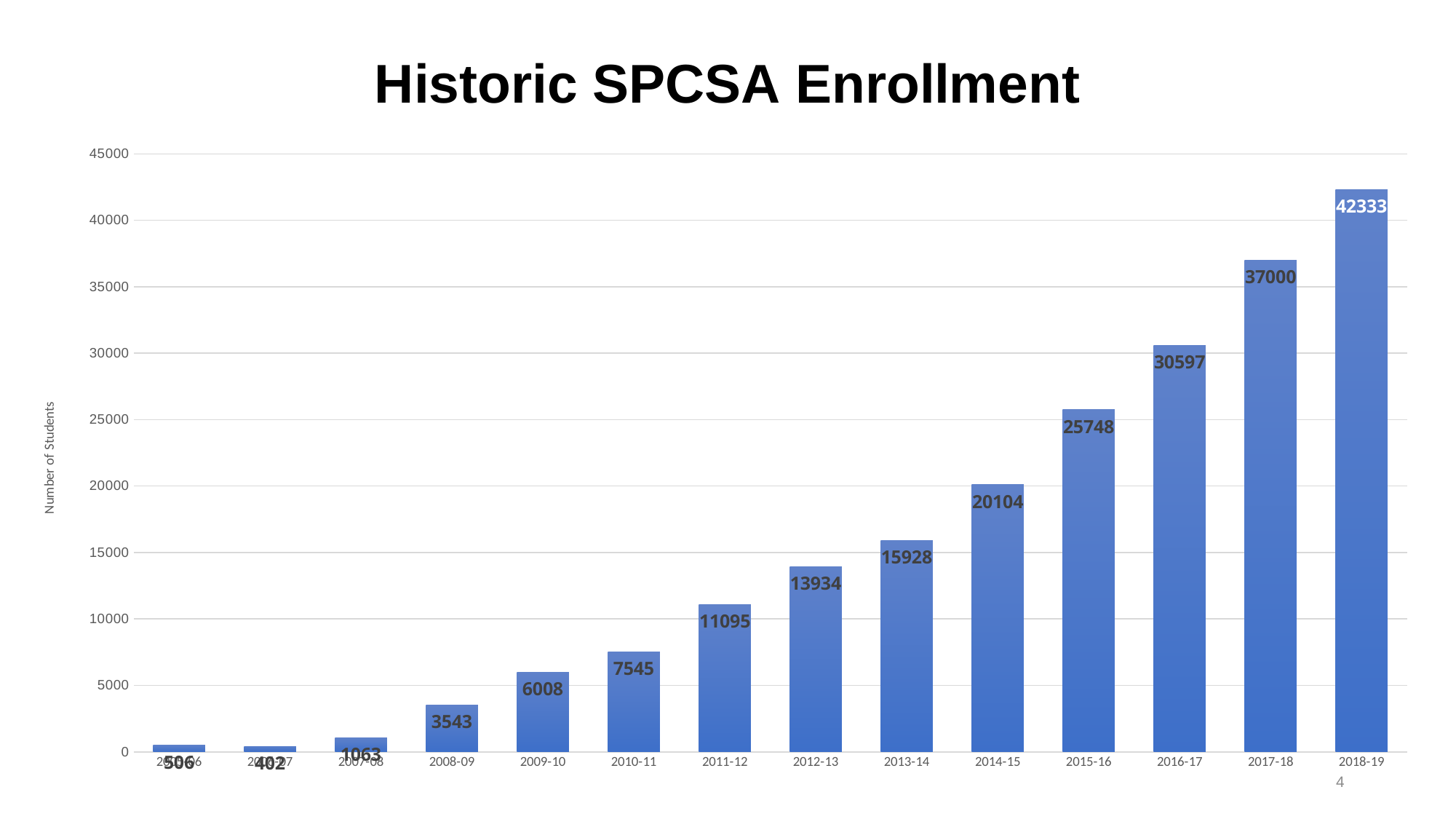
Which school year has the highest enrollment? 2018-19 What is the difference in enrollment between 2018-19 and 2017-18? 5333 What is the enrollment value for 2012-13? 13934 Which has higher enrollment, 2011-12 or 2013-14? 2013-14 What kind of chart is shown on the slide? Bar chart What is the enrollment value for 2009-10? 6008 How many school years are shown in the chart? 14 Does enrollment generally rise or fall from 2007-08 to 2018-19? Rise What is the difference in enrollment between 2016-17 and 2015-16? 4849 Is the enrollment for 2014-15 greater or less than 20000? greater What is the enrollment value for 2018-19? 42333 What is the enrollment value for 2015-16? 25748